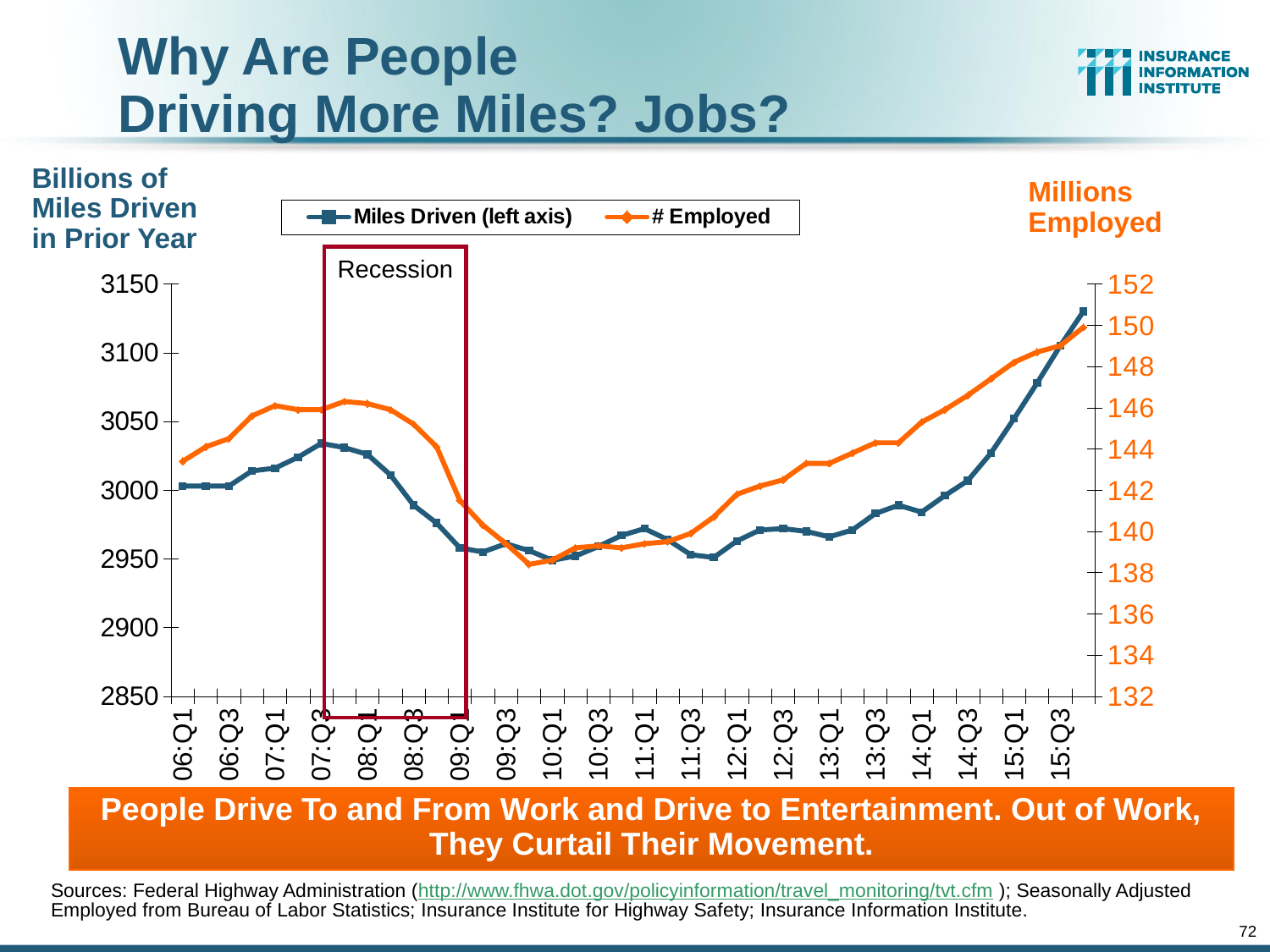
Is the value for # Employed at 09:Q3 greater or less than 140? less How many series does the legend list? 2 Is the value for Miles Driven at 09:Q3 greater or less than 3000? less Is the value for # Employed at 15:Q3 greater or less than 146? greater Which is larger for Miles Driven: the value at 07:Q3 or the value at 09:Q3? 07:Q3 What label is shown inside the red box on the chart? Recession Does the Miles Driven series rise or fall from 13:Q1 to 15:Q3? Rise Does the # Employed series rise or fall from 07:Q3 to 09:Q3? Fall What are the two series named in the legend? Miles Driven (left axis) and # Employed What kind of chart is shown on the slide? Line chart Which is larger for # Employed: the value at 06:Q1 or the value at 15:Q3? 15:Q3